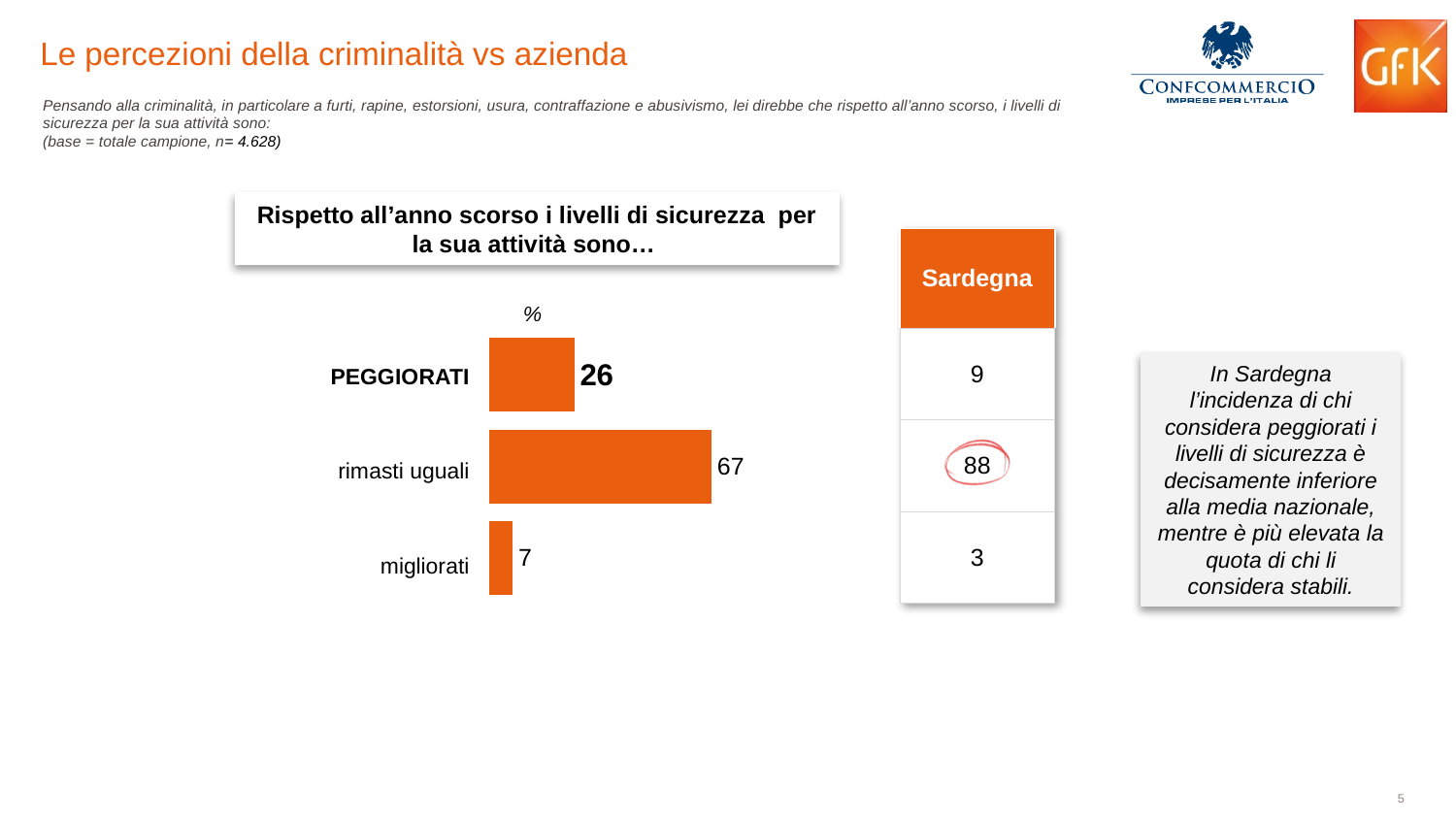
What is the value for PEGGIORATI in the bar chart? 26 What is the value for 'migliorati' in the bar chart? 7 What is the difference between the values for 'rimasti uguali' and PEGGIORATI in the bar chart? 41 How many categories are shown in the bar chart? 3 Which category has the highest value in the bar chart? rimasti uguali What is the difference between the values for PEGGIORATI and 'migliorati' in the bar chart? 19 Which is larger in the bar chart, the value for PEGGIORATI or the value for 'migliorati'? PEGGIORATI Which category has the lowest value in the bar chart? migliorati What is the title of the bar chart? Rispetto all'anno scorso i livelli di sicurezza per la sua attività sono… What kind of chart is shown on the slide? bar chart What is the value for 'rimasti uguali' in the bar chart? 67 What unit is indicated above the bars in the bar chart? %